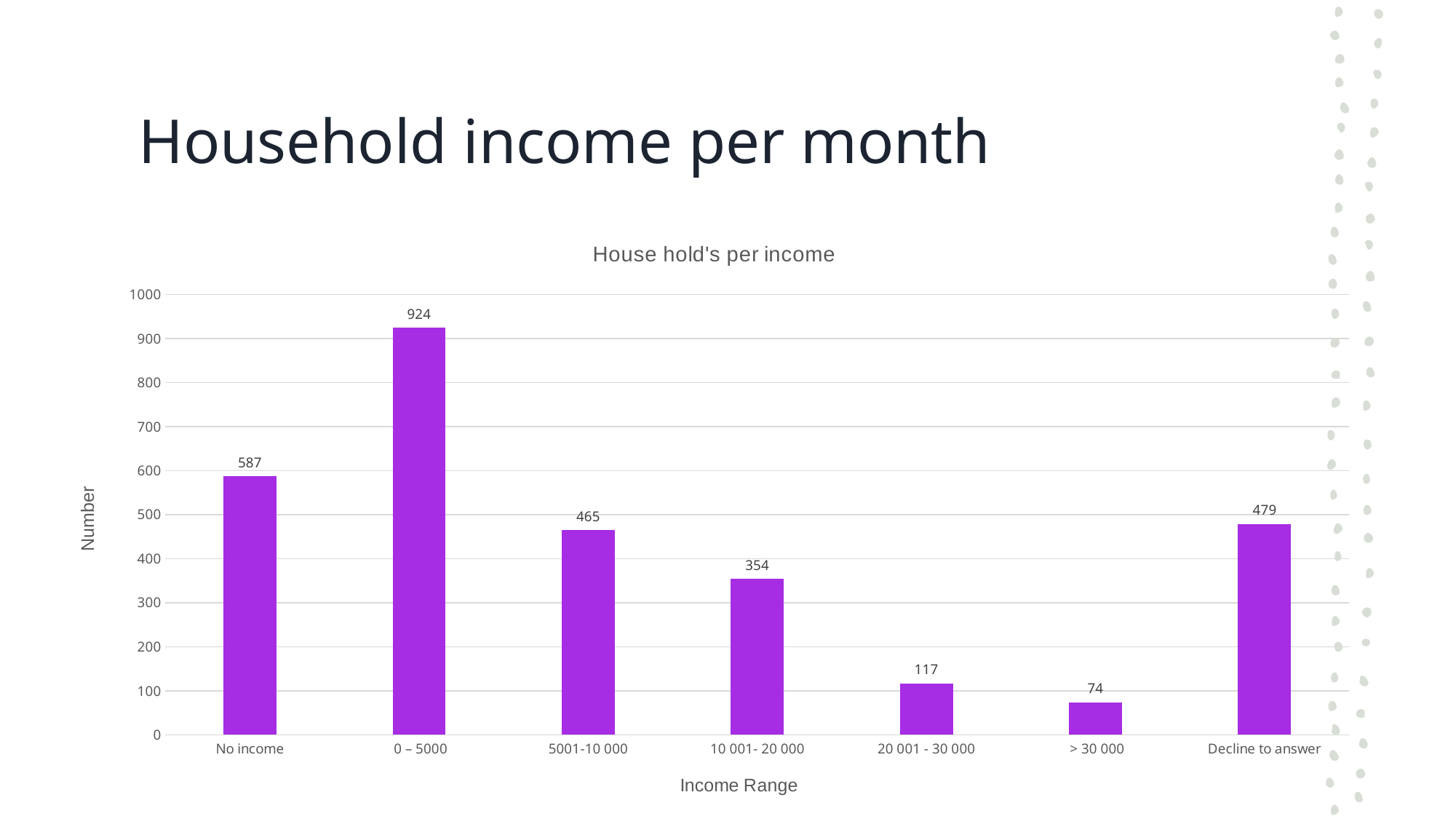
What is the value for the 0 – 5000 income range? 924 What is the difference between the values for 5001-10 000 and 10 001- 20 000? 111 What is the difference between the values for 0 – 5000 and No income? 337 How many income range categories are shown on the chart? 7 Which income range has the lowest number of households? > 30 000 What is the title of the chart? House hold's per income What is the value for Decline to answer? 479 What is the value for the > 30 000 income range? 74 What is the value for No income? 587 Which is larger, the value for No income or the value for Decline to answer? No income What kind of chart is shown on the slide? Bar chart Which income range has the highest number of households? 0 – 5000